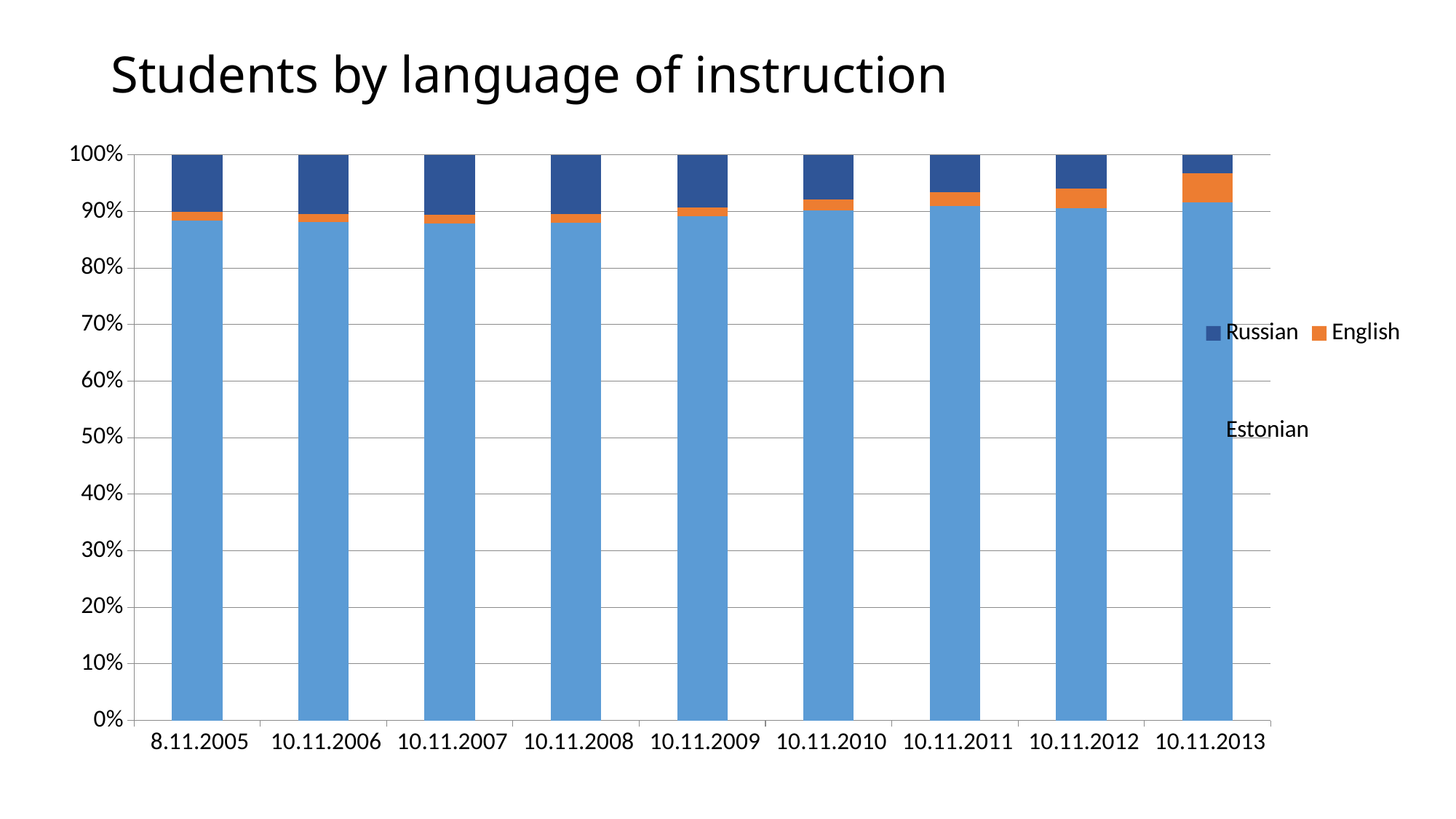
How many dates are shown on the x axis? 9 What is the total of the stacked bar for 10.11.2010? 100% Is the Estonian share for 10.11.2007 greater or less than 90%? less Does the Russian share rise or fall from 8.11.2005 to 10.11.2013? fall How many series does the legend list? 3 Is the Estonian share for 8.11.2005 greater or less than 80%? greater What is the title of the chart? Students by language of instruction What kind of chart is shown on the slide? Stacked bar chart Which series is shown in orange in the legend? English In which year does the English segment reach its largest share? 10.11.2013 Does the English share rise or fall from 8.11.2005 to 10.11.2013? rise In which year is the Russian segment smallest? 10.11.2013